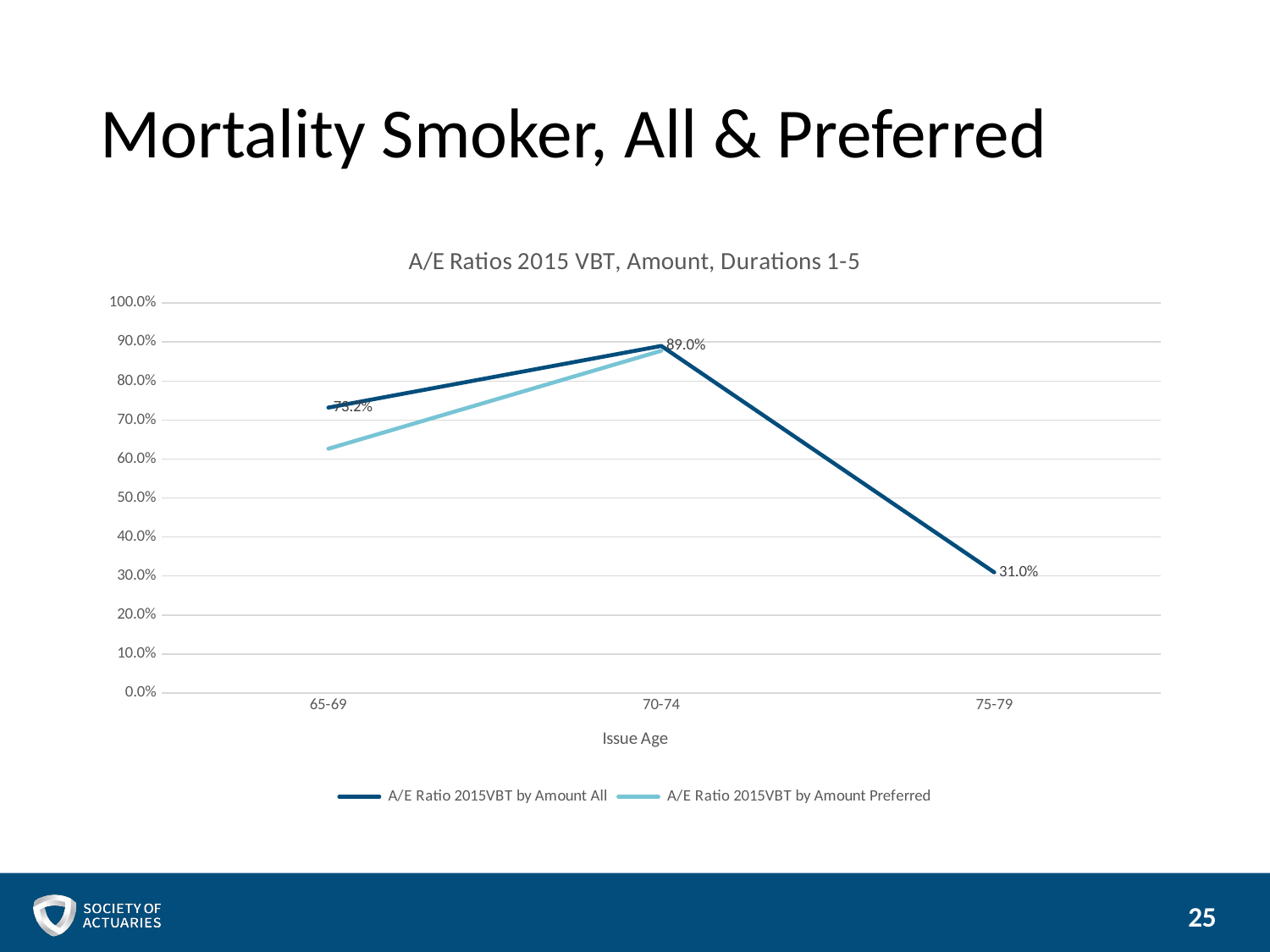
Which issue age group has the lowest A/E Ratio 2015VBT by Amount All? 75-79 What is the A/E Ratio 2015VBT by Amount All for issue age 70-74? 89.0% What is the title of the x axis? Issue Age What is the A/E Ratio 2015VBT by Amount All for issue age 75-79? 31.0% Is the A/E Ratio 2015VBT by Amount Preferred for issue age 65-69 greater or less than 70.0%? less What kind of chart is shown on the slide? line chart How many issue age groups are shown on the x axis? 3 At issue age 65-69, which series has the larger value: A/E Ratio by Amount All or A/E Ratio by Amount Preferred? A/E Ratio 2015VBT by Amount All What is the difference between the A/E Ratio by Amount All at issue age 70-74 and at 75-79? 58.0% Which issue age group has the highest A/E Ratio 2015VBT by Amount All? 70-74 How many series does the legend list? 2 What is the A/E Ratio 2015VBT by Amount All for issue age 65-69? 73.2%